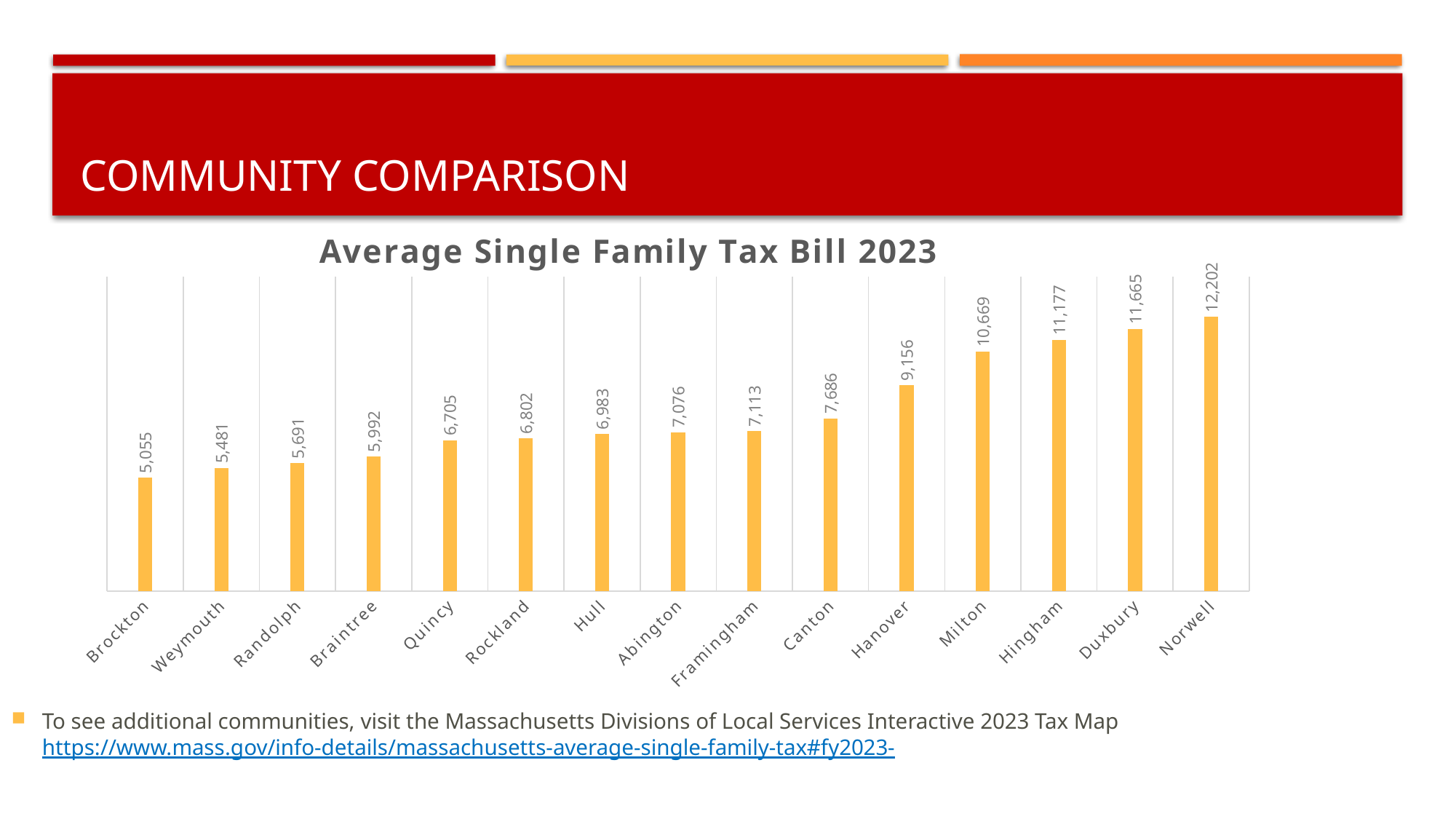
Which has a lower average single family tax bill, Weymouth or Randolph? Weymouth Which community has the highest average single family tax bill? Norwell What is the value shown for Brockton? 5,055 What is the average single family tax bill for Hingham? 11,177 Which has a higher average single family tax bill, Canton or Hanover? Hanover How many communities are shown in the chart? 15 Which community has the lowest average single family tax bill? Brockton What is the title of the chart? Average Single Family Tax Bill 2023 What is the difference between the tax bills for Norwell and Brockton? 7,147 What is the difference between the tax bills for Duxbury and Milton? 996 What kind of chart is shown on the slide? Bar chart What is the average single family tax bill for Quincy? 6,705